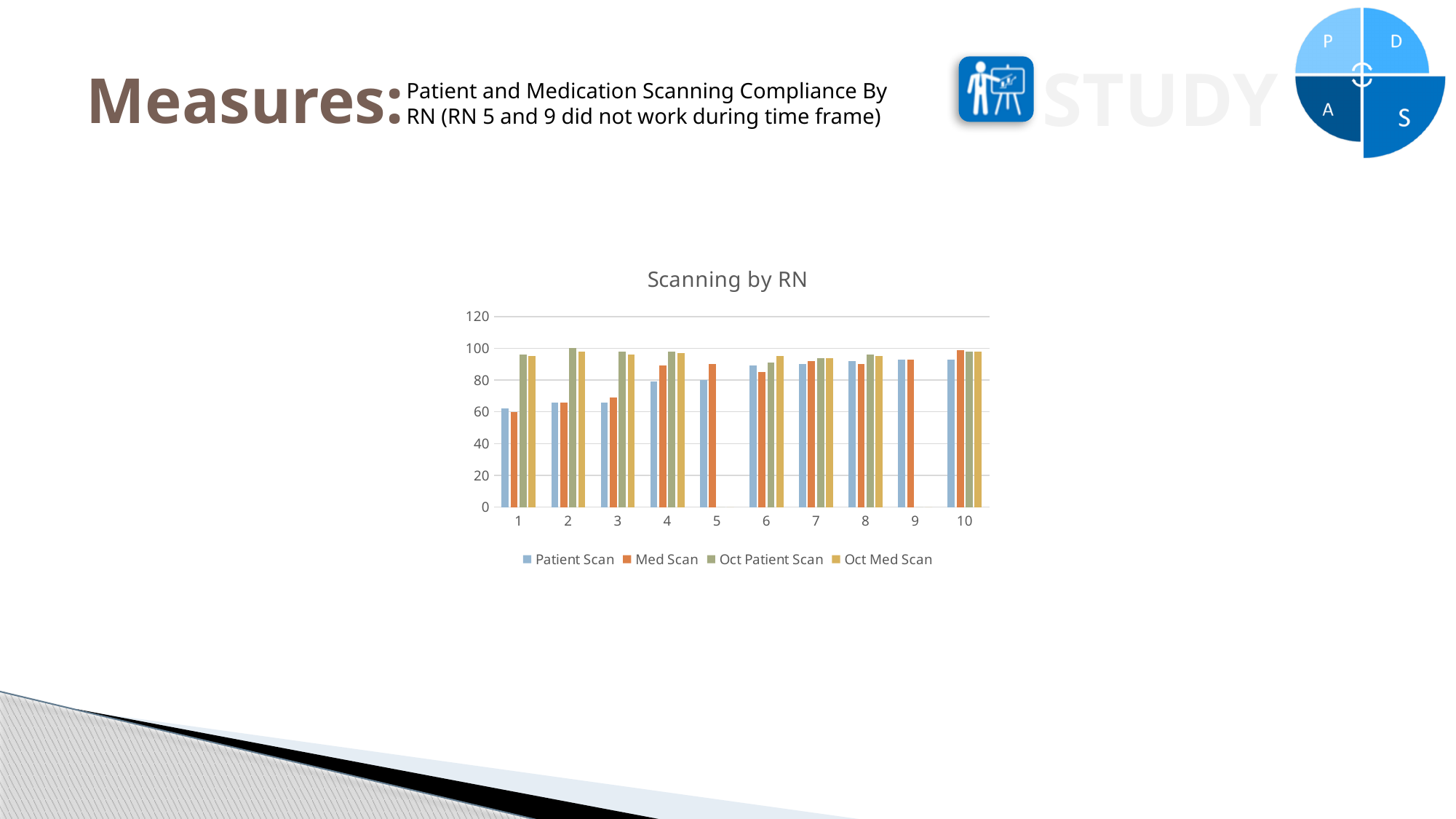
What kind of chart is shown on the slide? bar chart For RN 1, which is larger: the Patient Scan value or the Oct Patient Scan value? Oct Patient Scan Is the Patient Scan value for RN 4 greater or less than 100? less How many RN categories are shown on the x axis? 10 How many series does the legend list? 4 What is the title of the chart? Scanning by RN For RN 3, which is larger: the Med Scan value or the Oct Med Scan value? Oct Med Scan Which series are listed in the legend? Patient Scan, Med Scan, Oct Patient Scan, Oct Med Scan Is the Med Scan value for RN 5 greater or less than 60? greater Do the Patient Scan values generally rise or fall from RN 1 to RN 10? rise Is the Oct Patient Scan value for RN 2 greater or less than 80? greater